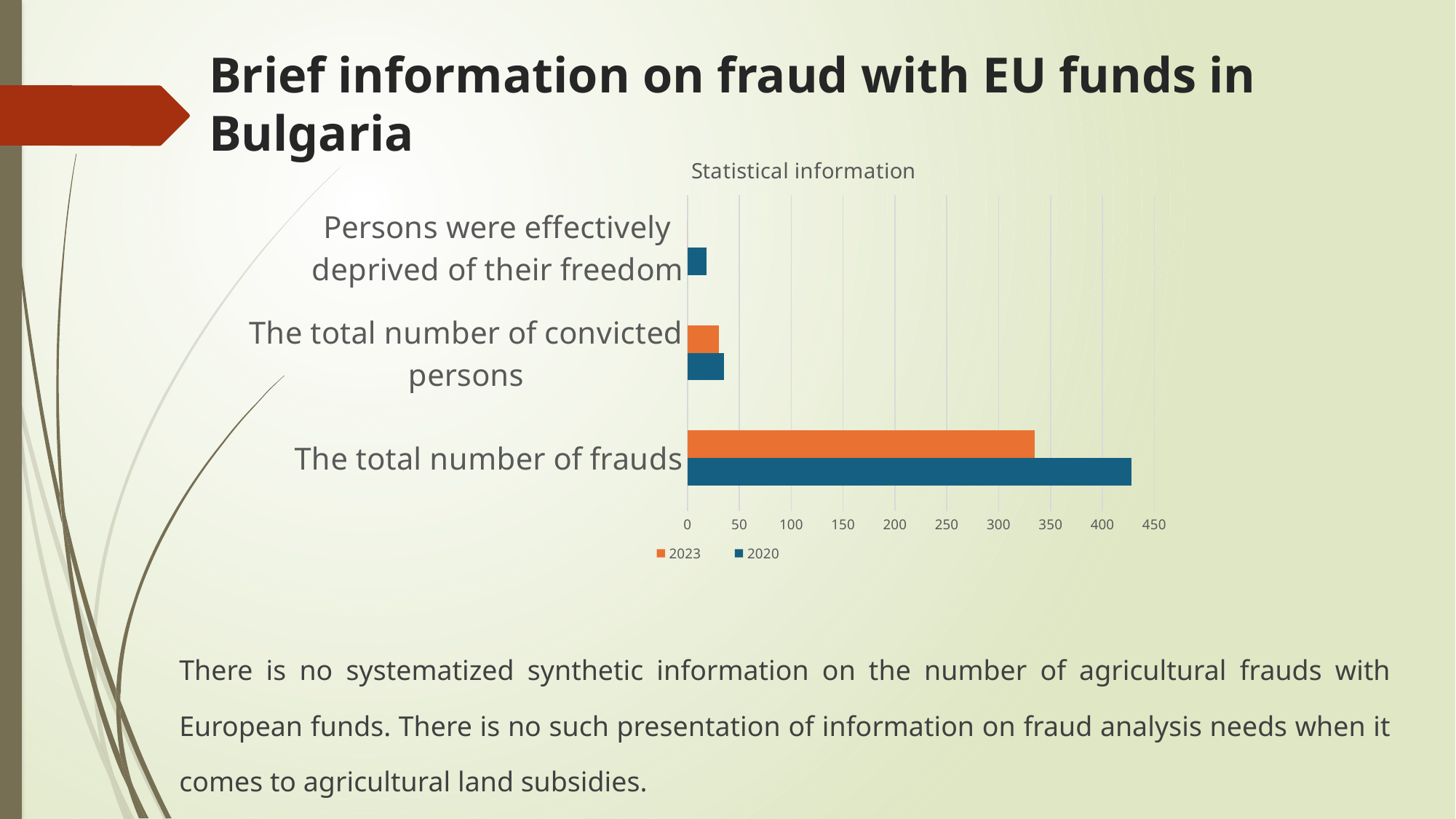
Is the 2020 value for the total number of frauds greater or less than 400? greater Is the 2020 value for the total number of convicted persons greater or less than 50? less Which category has the highest value for 2020? The total number of frauds Which category has the lowest value for 2020? Persons were effectively deprived of their freedom What is the title of the chart? Statistical information How many categories are shown on the chart? 3 Which years are listed in the chart legend? 2023 and 2020 Is the 2023 value for the total number of frauds greater or less than 300? greater What kind of chart is shown on the slide? bar chart For the total number of frauds, which year has the larger value, 2020 or 2023? 2020 Which category has the highest value for 2023? The total number of frauds How many series does the chart legend list? 2